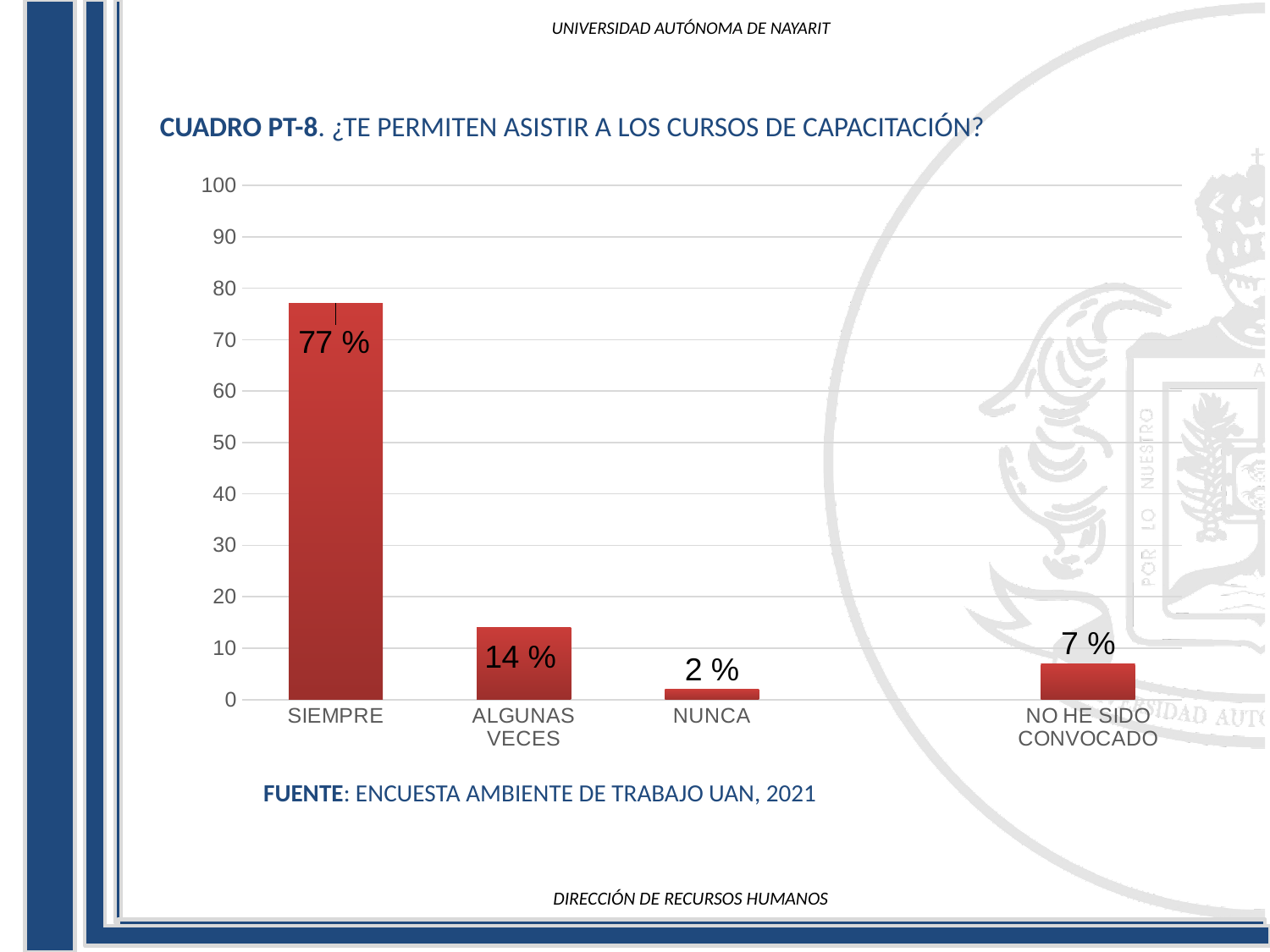
How many categories are shown on the x axis? 4 What is the value for ALGUNAS VECES? 14 % What is the value for NO HE SIDO CONVOCADO? 7 % Is the value for SIEMPRE greater or less than 70? greater What is the title of the chart? CUADRO PT-8. ¿TE PERMITEN ASISTIR A LOS CURSOS DE CAPACITACIÓN? Which category has the highest value? SIEMPRE What is the value for SIEMPRE? 77 % Which is larger, the value for NO HE SIDO CONVOCADO or the value for NUNCA? NO HE SIDO CONVOCADO What is the value for NUNCA? 2 % Which category has the lowest value? NUNCA What kind of chart is shown on the slide? bar chart What is the difference between the values for SIEMPRE and ALGUNAS VECES? 63 %